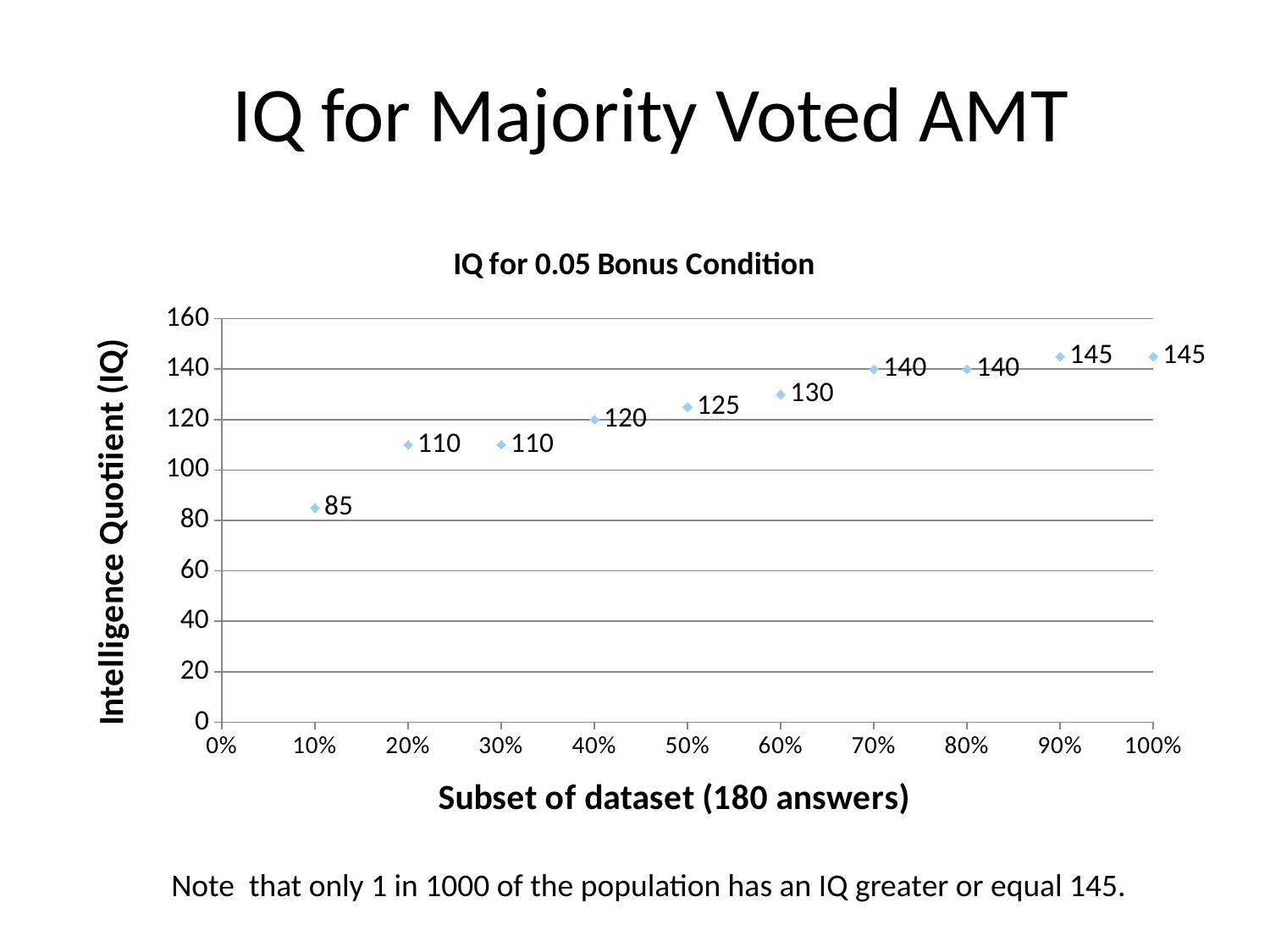
What is the IQ value at 60% of the dataset? 130 What is the title of the chart? IQ for 0.05 Bonus Condition What is the difference between the IQ value at 50% and the IQ value at 40%? 5 What kind of chart is shown on the slide? Scatter chart What is the IQ value at 100% of the dataset? 145 How many data points are plotted on the chart? 10 At which subset percentage is the IQ value lowest? 10% What is the IQ value at 10% of the dataset? 85 What is the difference between the IQ value at 100% and the IQ value at 10%? 60 What is the highest IQ value plotted on the chart? 145 Do the IQ values rise or fall as the subset of the dataset increases from 10% to 100%? Rise Which is larger, the IQ value at 20% or the IQ value at 70%? 70%